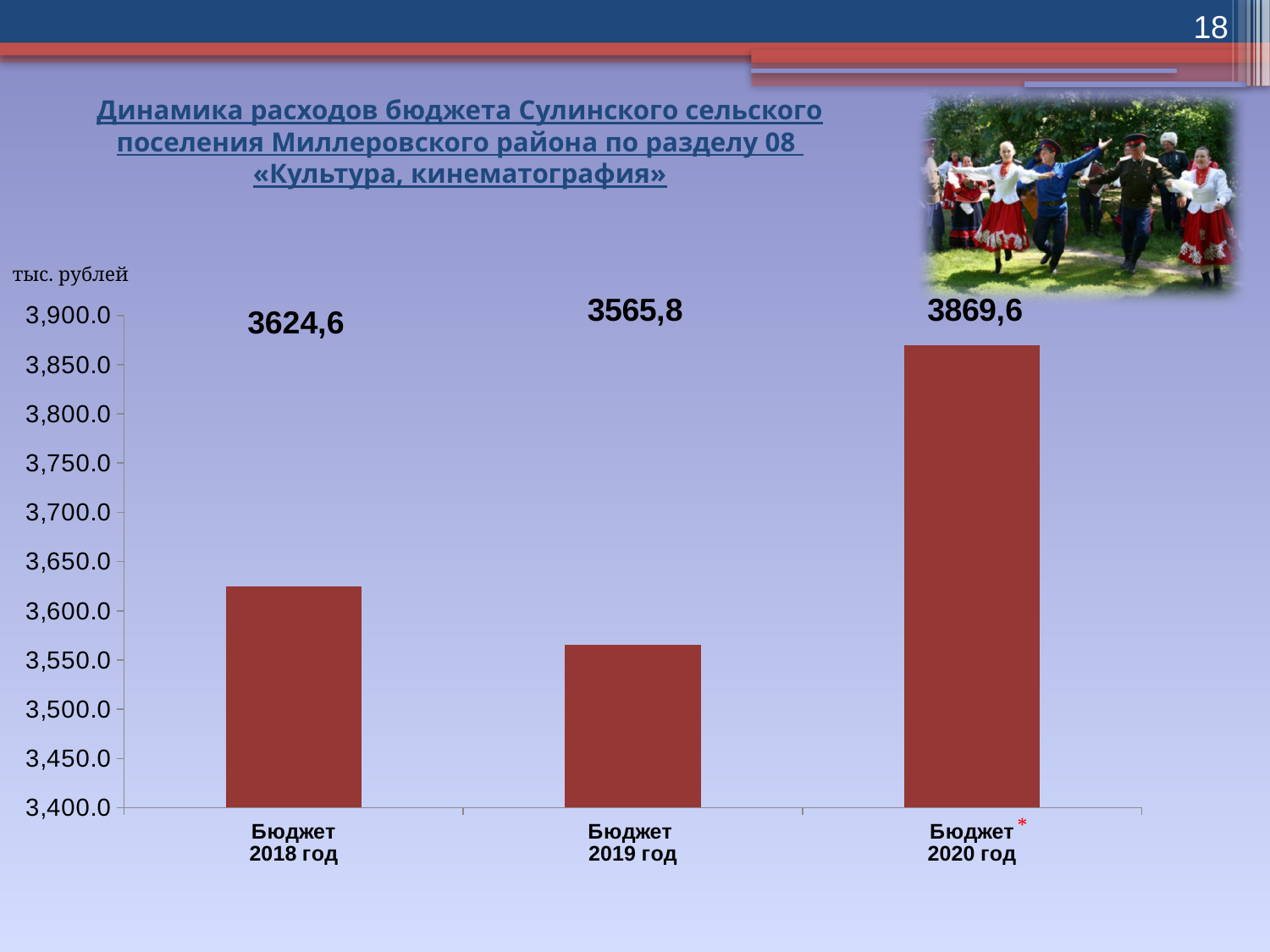
Which is larger: the value for Бюджет 2018 год or Бюджет 2019 год? Бюджет 2018 год Is the value for Бюджет 2020 год greater or less than 3,800.0? greater What is the difference between the values for Бюджет 2020 год and Бюджет 2018 год? 245,0 What kind of chart is shown on the slide? bar chart What is the value for Бюджет 2018 год? 3624,6 Which year has the highest budget expenditure on the chart? Бюджет 2020 год How many bars are shown on the chart? 3 Which year has the lowest budget expenditure on the chart? Бюджет 2019 год What is the difference between the values for Бюджет 2018 год and Бюджет 2019 год? 58,8 What is the value for Бюджет 2020 год? 3869,6 What is the value for Бюджет 2019 год? 3565,8 In what units are the values on the chart expressed? тыс. рублей